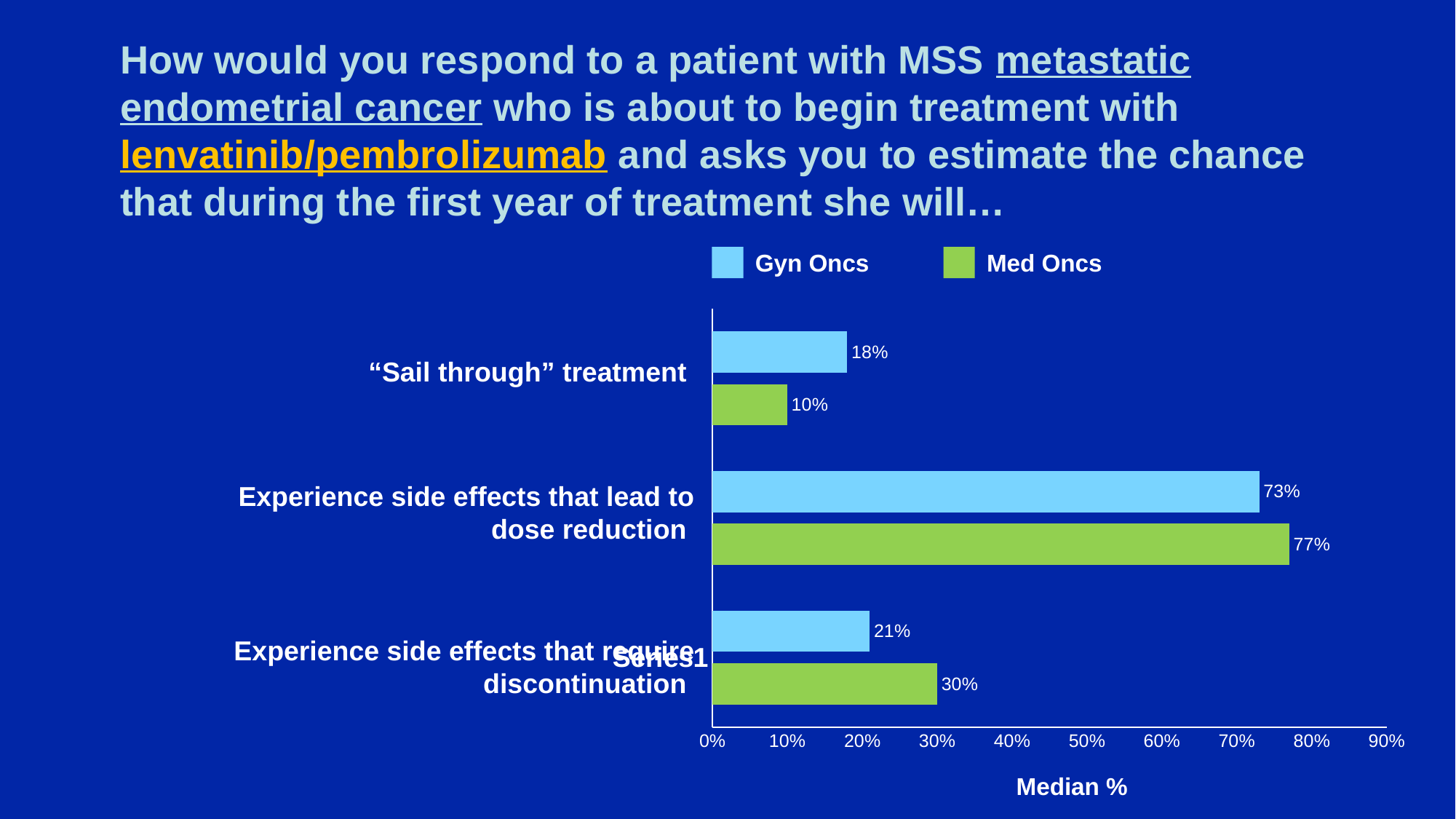
How many categories are shown on the chart? 3 For side effects that require discontinuation, which group has the larger value, Gyn Oncs or Med Oncs? Med Oncs Which category has the lowest Gyn Oncs value? "Sail through" treatment Which category has the highest Med Oncs value? Experience side effects that lead to dose reduction What is the Med Oncs value for experiencing side effects that require discontinuation? 30% What is the Gyn Oncs value for "Sail through" treatment? 18% How many series does the legend list? 2 What is the Med Oncs value for "Sail through" treatment? 10% What is the difference between the Med Oncs and Gyn Oncs values for side effects that lead to dose reduction? 4% What is the Gyn Oncs value for experiencing side effects that lead to dose reduction? 73% What is the label of the horizontal axis? Median % What kind of chart is shown on the slide? Bar chart